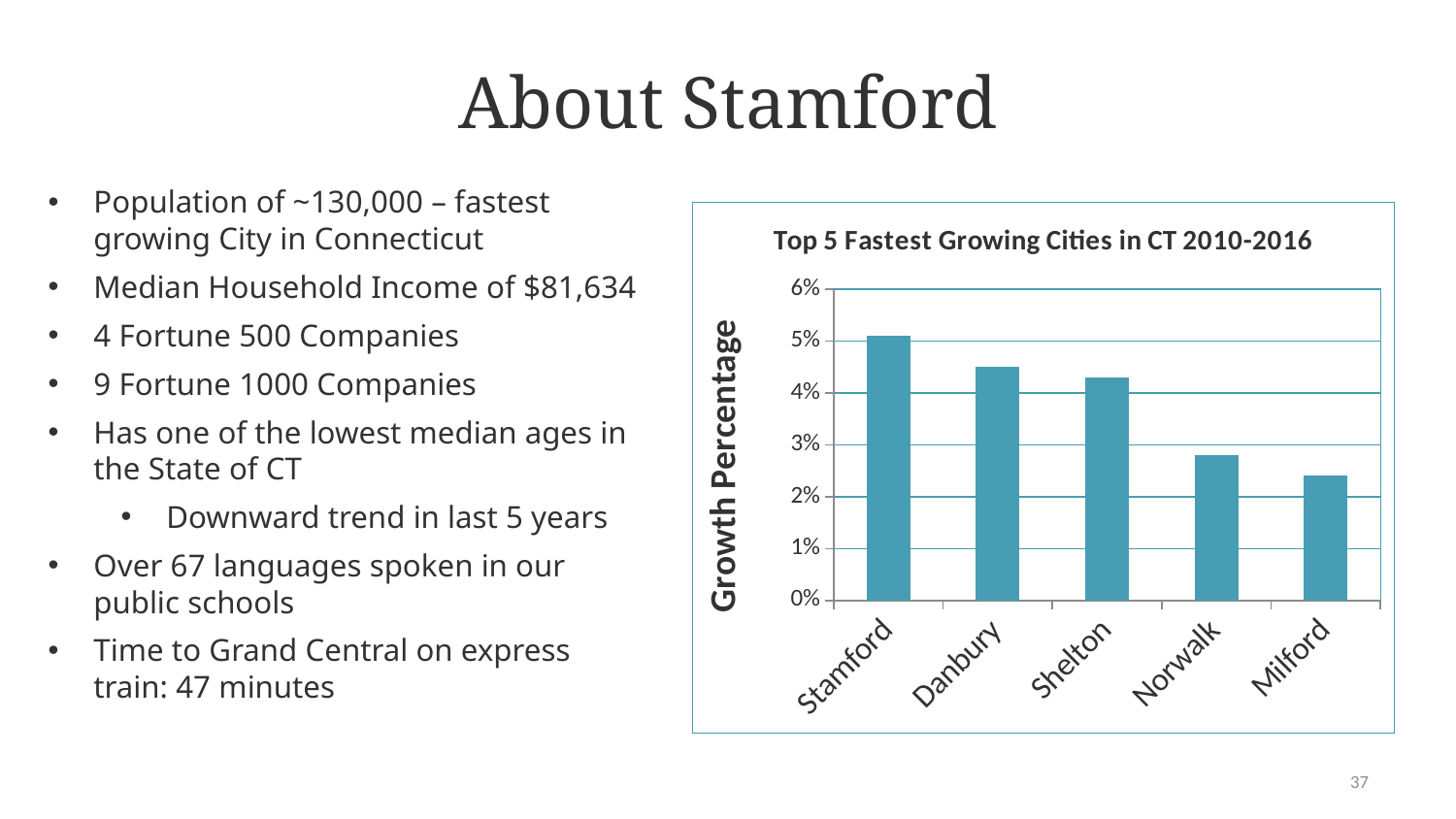
Which city has the lowest growth percentage in the chart? Milford Is the growth percentage for Shelton greater or less than 5%? less Do the growth percentages rise or fall from left to right across the cities? fall How many cities are shown in the chart? 5 Which city has the highest growth percentage in the chart? Stamford What kind of chart is shown on the slide? bar chart Is the growth percentage for Danbury greater or less than 4%? greater Is the growth percentage for Norwalk greater or less than 3%? less Which city has a higher growth percentage, Stamford or Norwalk? Stamford What is the title of the chart? Top 5 Fastest Growing Cities in CT 2010-2016